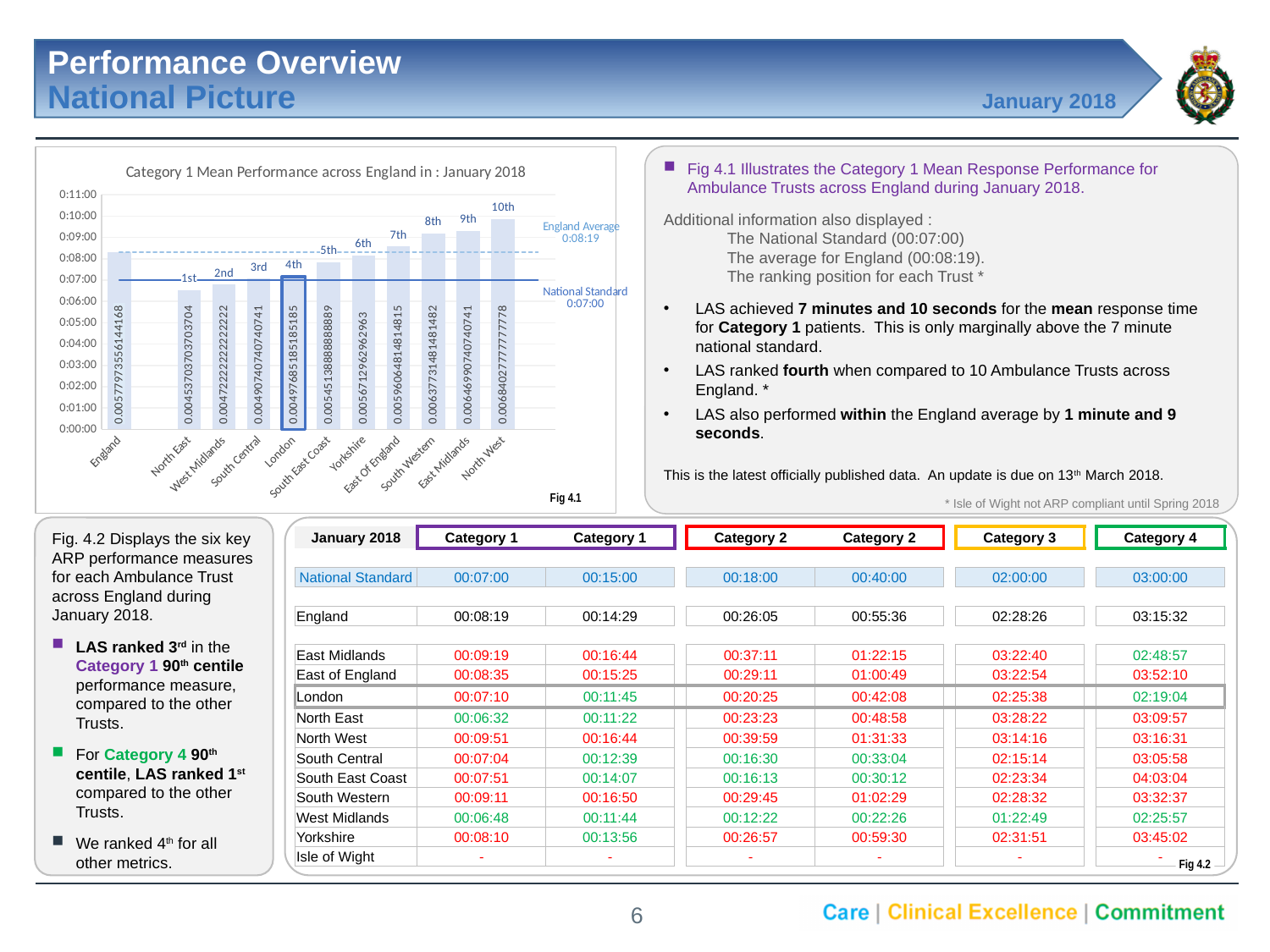
Is the value for East Of England greater or less than 0:08:00? greater What rank label is shown above the London bar? 4th Which bar is taller, North West or North East? North West Is the value for North West greater or less than 0:09:00? greater Which trust has the lowest bar in the chart? North East What is the title of the chart? Category 1 Mean Performance across England in : January 2018 Do the trust bars rise or fall from left to right after the England bar? rise Which trust has the highest bar in the chart? North West What type of chart is shown on the slide? bar chart How many bars are plotted in the chart? 11 What England Average value is printed on the chart? 0:08:19 Is the value for North East greater or less than 0:07:00? less